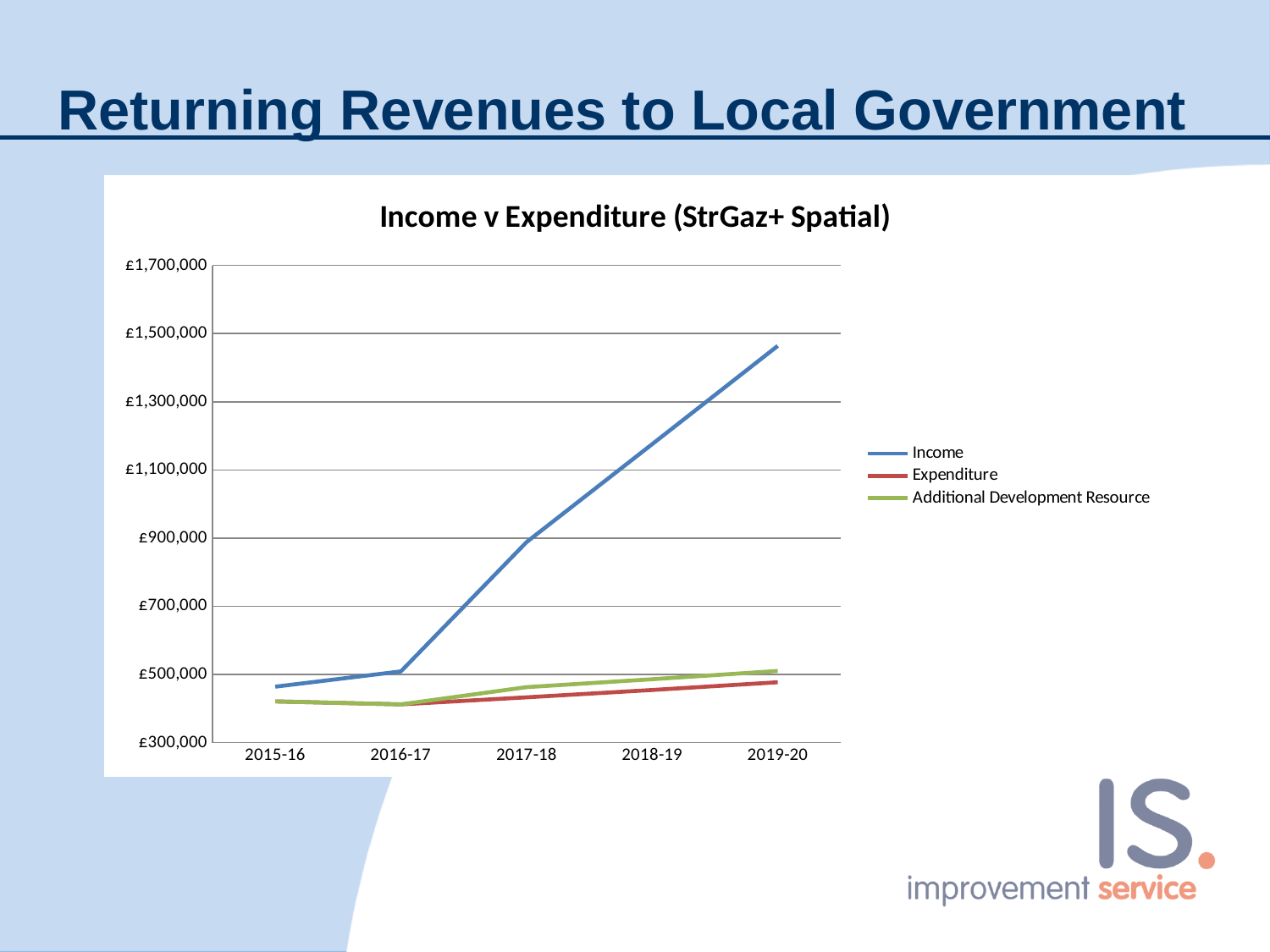
Is the value for Income in 2019-20 greater or less than £1,300,000? greater How many series does the legend list? 3 Is the value for Expenditure in 2019-20 greater or less than £500,000? less Is the value for Income in 2018-19 greater or less than £1,100,000? greater In 2019-20, which is larger: Income or Expenditure? Income In which year is Income at its highest? 2019-20 How many years are plotted along the x axis? 5 What is the title of the chart? Income v Expenditure (StrGaz+ Spatial) Does Income rise or fall from 2015-16 to 2019-20? rise What kind of chart is shown on the slide? line chart Which series is shown in blue? Income